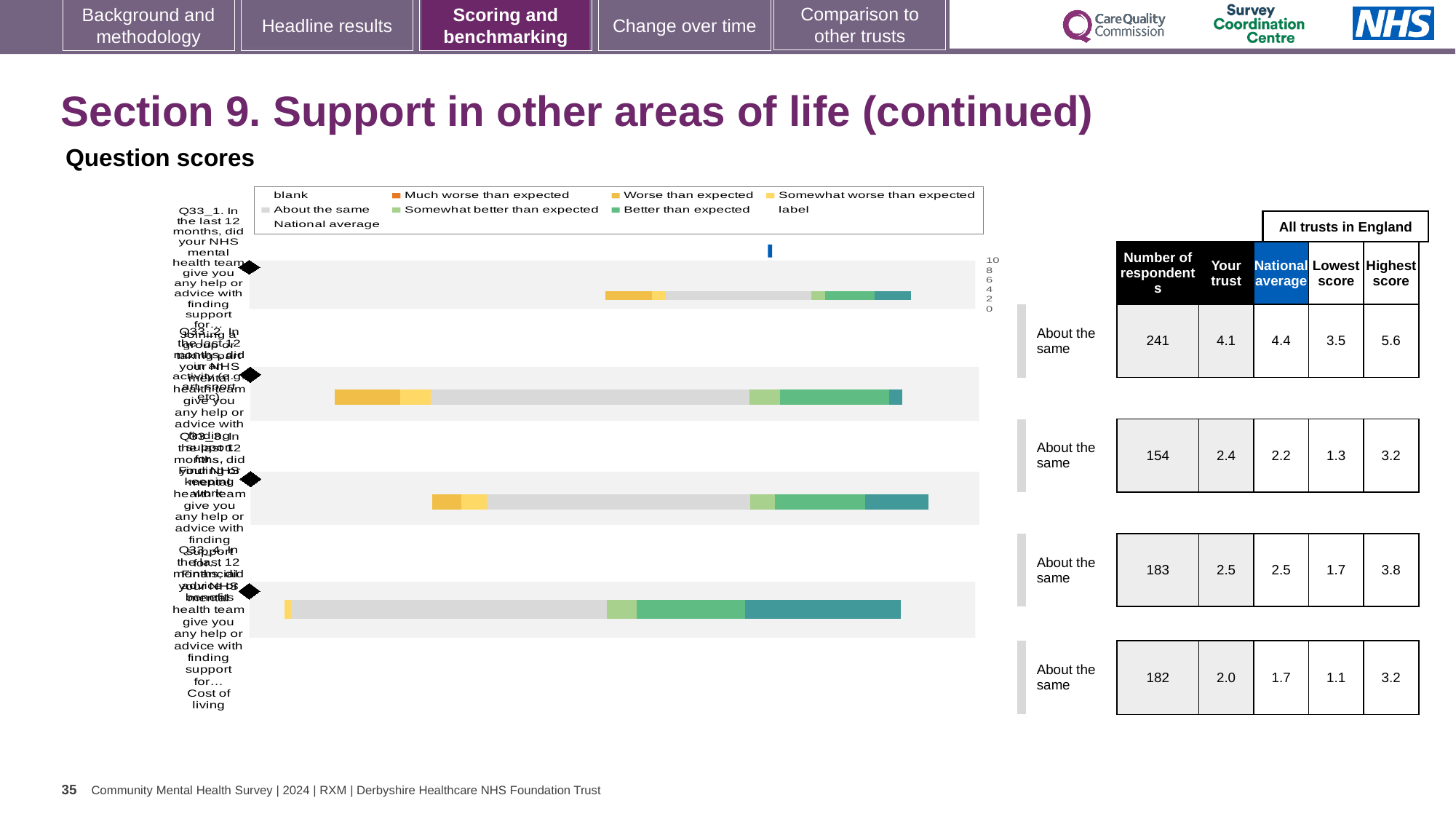
In the table beside the chart, for the second row (Q33_2), is the 'Your trust' score or the national average larger? Your trust (2.4) How many question bars (Q33_1 to Q33_4) are plotted in the chart? 4 In the table beside the chart, which row has the highest number of respondents? The first row (Q33_1), 241 How many entries does the chart legend list? 9 Which legend entry is shown in dark orange? Much worse than expected In the table beside the chart, what is the national average for the last row (Q33_4)? 1.7 In the table beside the chart, what is the difference between the highest score and the lowest score for the first row (Q33_1)? 2.1 In the table beside the chart, what is the 'Your trust' score for the first row (Q33_1)? 4.1 What benchmark label is shown beside each of the four question bars? About the same In the table beside the chart, what is the number of respondents for the first row (Q33_1)? 241 What kind of chart is shown under 'Question scores'? bar chart In the table beside the chart, what is the lowest score for the third row (Q33_3)? 1.7